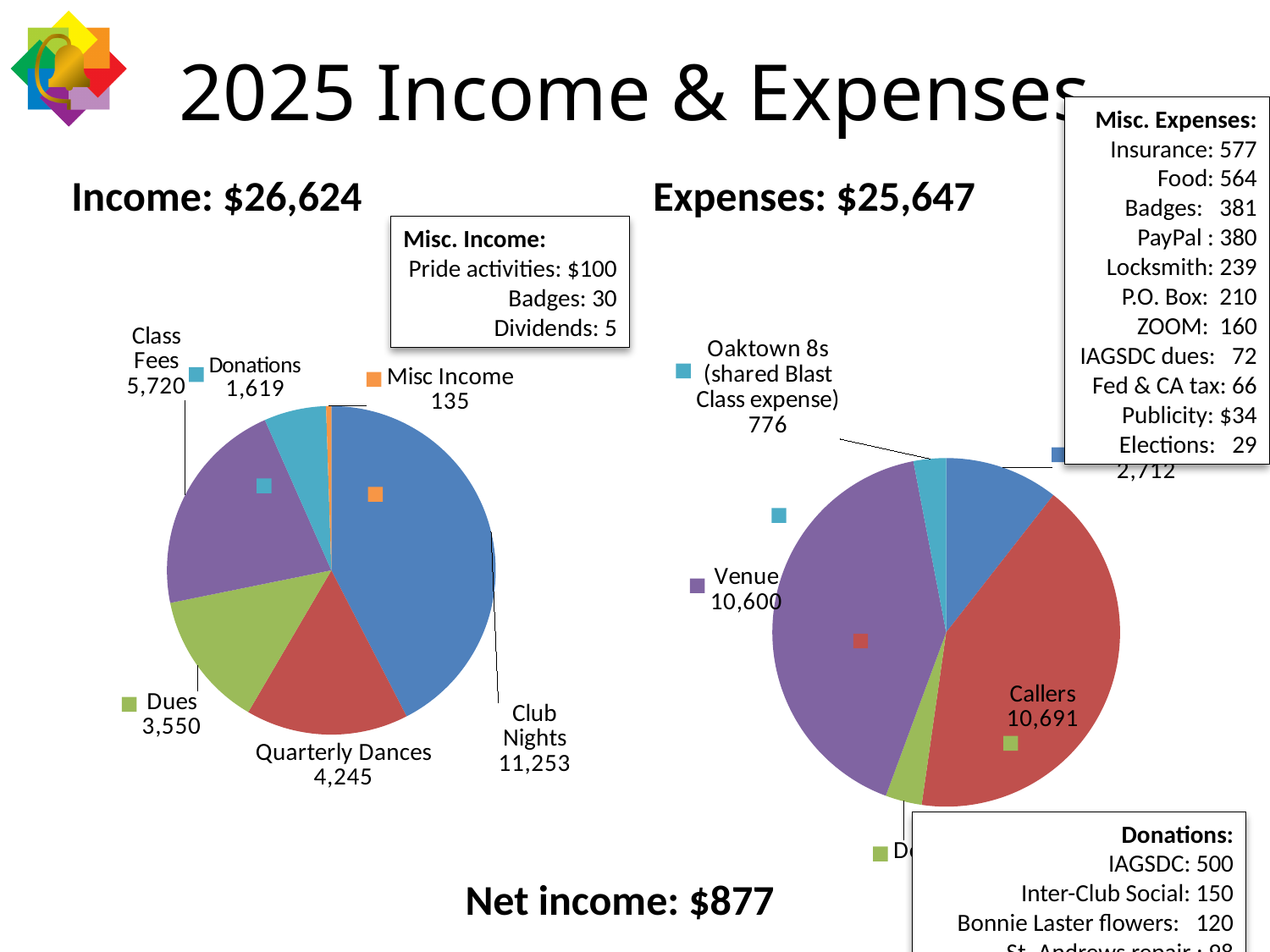
On the Expenses pie chart, what is the value for Venue? 10,600 On the Income pie chart, which category has the largest value? Club Nights On the Income pie chart, what is the value for Club Nights? 11,253 On the Income pie chart, what is the difference between Club Nights and Quarterly Dances? 7,008 On the Expenses pie chart, what is the value for Callers? 10,691 How many categories are shown on the Income pie chart? 6 On the Income pie chart, which is larger, Dues or Class Fees? Class Fees What type of chart is used to show the Expenses data? Pie chart On the Income pie chart, what is the value for Quarterly Dances? 4,245 On the Expenses pie chart, what is the value for Oaktown 8s (shared Blast Class expense)? 776 On the Income pie chart, which category has the smallest value? Misc Income On the Income pie chart, what is the value for Class Fees? 5,720